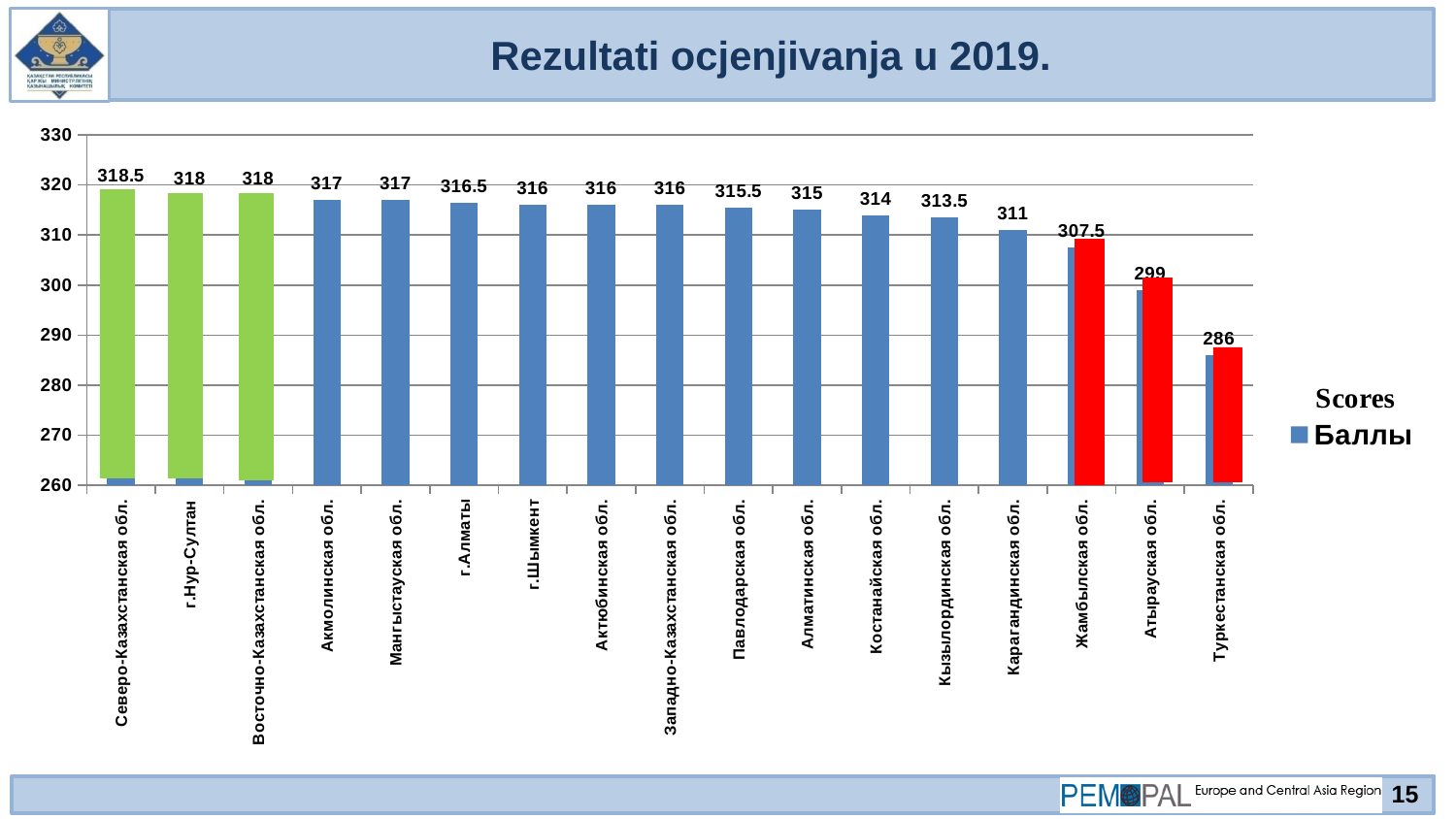
What is the value for г.Алматы? 316.5 What is the difference between the values for Жамбылская обл. and Атырауская обл.? 8.5 What kind of chart is shown on the slide? bar chart What is the value for Северо-Казахстанская обл.? 318.5 Which is larger, the value for Костанайская обл. or the value for Кызылординская обл.? Костанайская обл. Which category has the highest value? Северо-Казахстанская обл. What is the value for Карагандинская обл.? 311 What is the value for Туркестанская обл.? 286 How many categories are shown on the x axis? 17 What is the difference between the values for Северо-Казахстанская обл. and Туркестанская обл.? 32.5 How many series does the legend list? 1 Which category has the lowest value? Туркестанская обл.